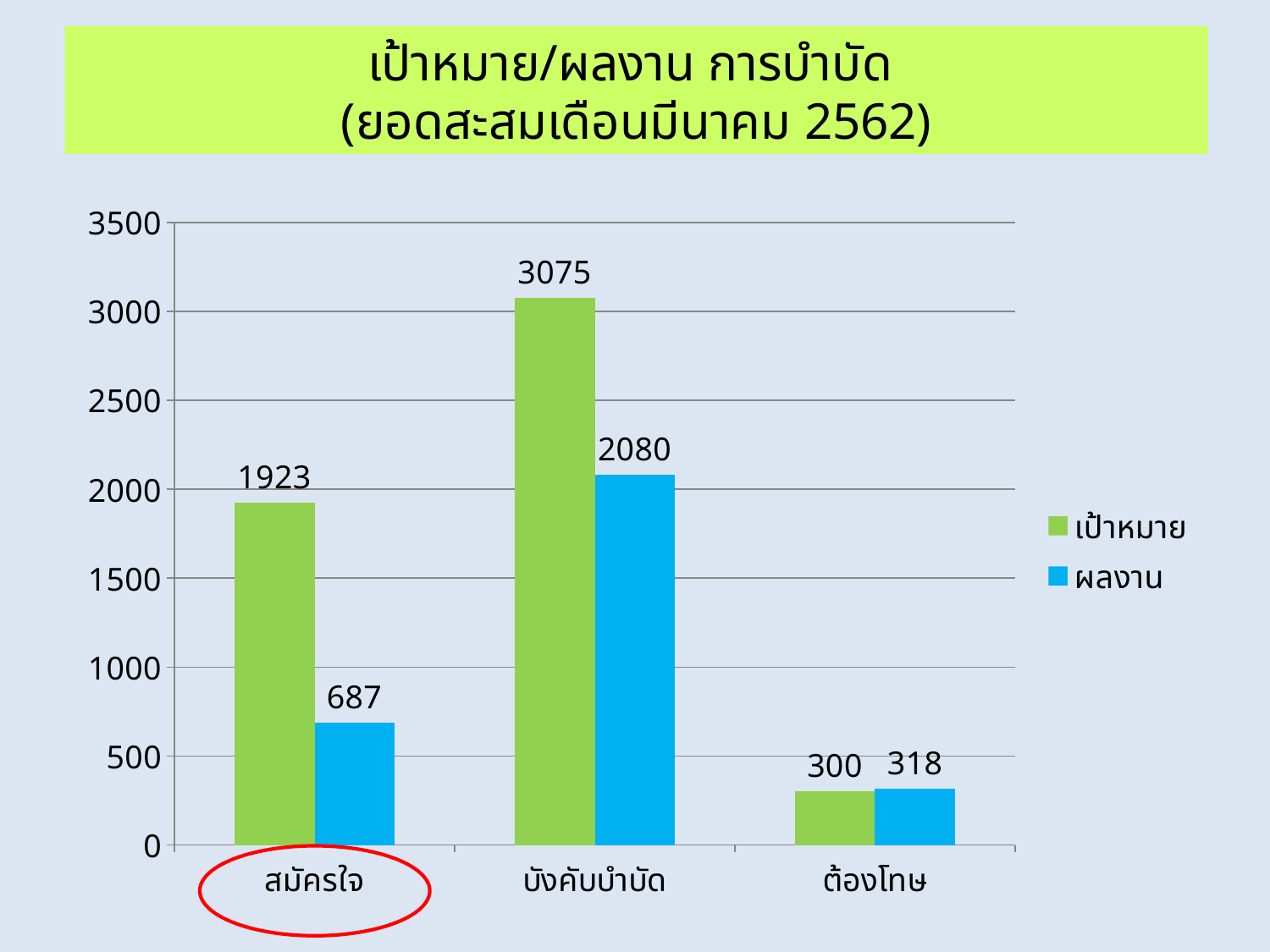
Which category on the x axis is circled in red? สมัครใจ What is the difference between the เป้าหมาย and ผลงาน values for บังคับบำบัด? 995 What is the ผลงาน value for ต้องโทษ? 318 Which category has the highest เป้าหมาย value? บังคับบำบัด How many categories are shown on the x axis? 3 How many series does the legend list? 2 What is the ผลงาน value for บังคับบำบัด? 2080 What is the difference between the เป้าหมาย and ผลงาน values for สมัครใจ? 1236 What is the เป้าหมาย value for สมัครใจ? 1923 Which is larger for ต้องโทษ, เป้าหมาย or ผลงาน? ผลงาน What kind of chart is shown on the slide? bar chart Which category has the lowest ผลงาน value? ต้องโทษ